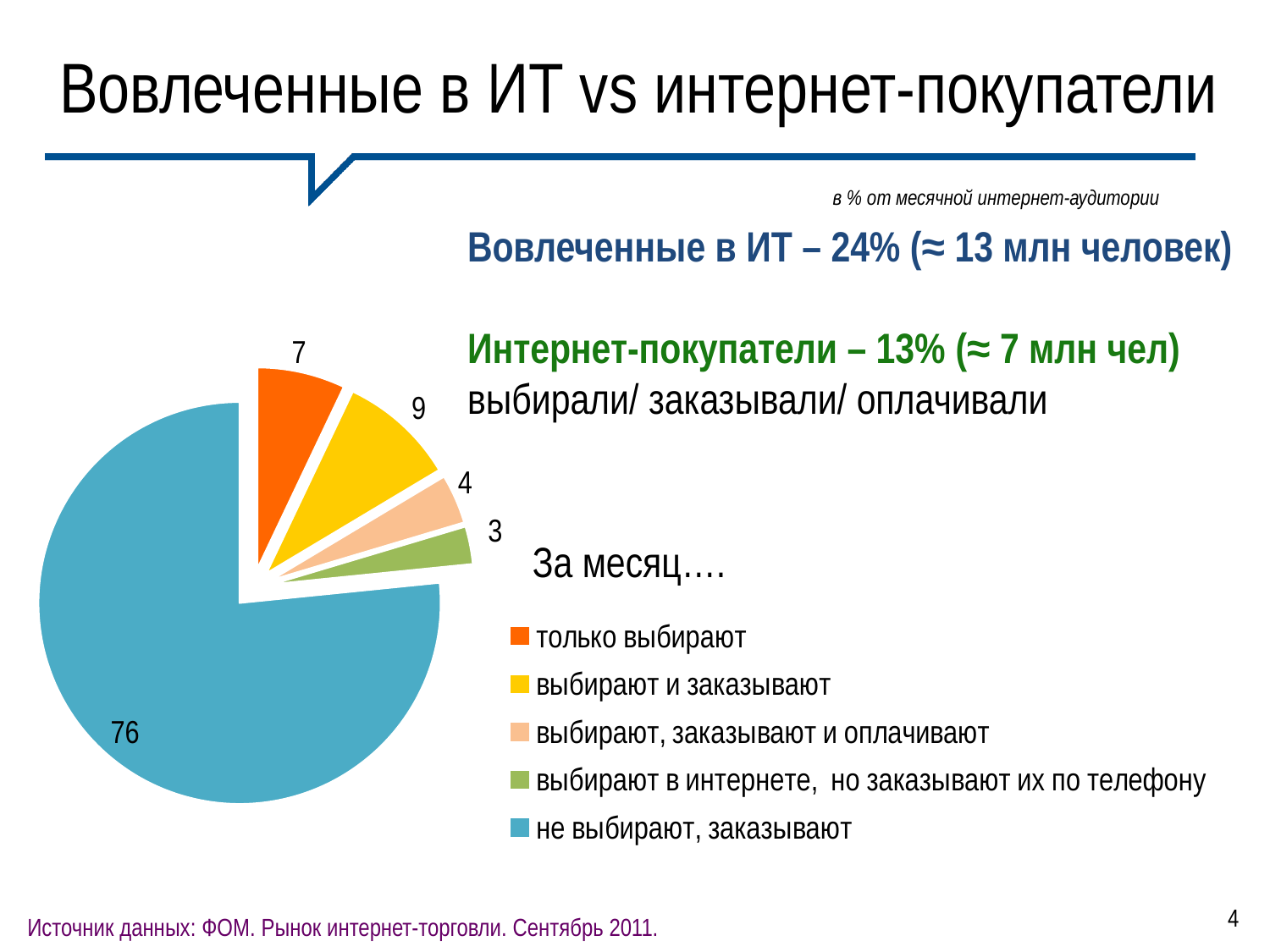
What is the difference between the values for "выбирают и заказывают" and "только выбирают"? 2 Which slice of the pie is the largest? не выбирают, заказывают What is the value for the slice "выбирают в интернете, но заказывают их по телефону"? 3 Which slice of the pie is the smallest? выбирают в интернете, но заказывают их по телефону Which is larger: the value for "только выбирают" or the value for "выбирают, заказывают и оплачивают"? только выбирают What kind of chart is shown on the slide? pie chart How many slices does the pie chart have? 5 What is the value for the slice "выбирают и заказывают"? 9 What is the value for the slice "выбирают, заказывают и оплачивают"? 4 What colour is the slice for "не выбирают, заказывают"? blue What is the value for the slice "только выбирают"? 7 What is the value for the slice "не выбирают, заказывают"? 76